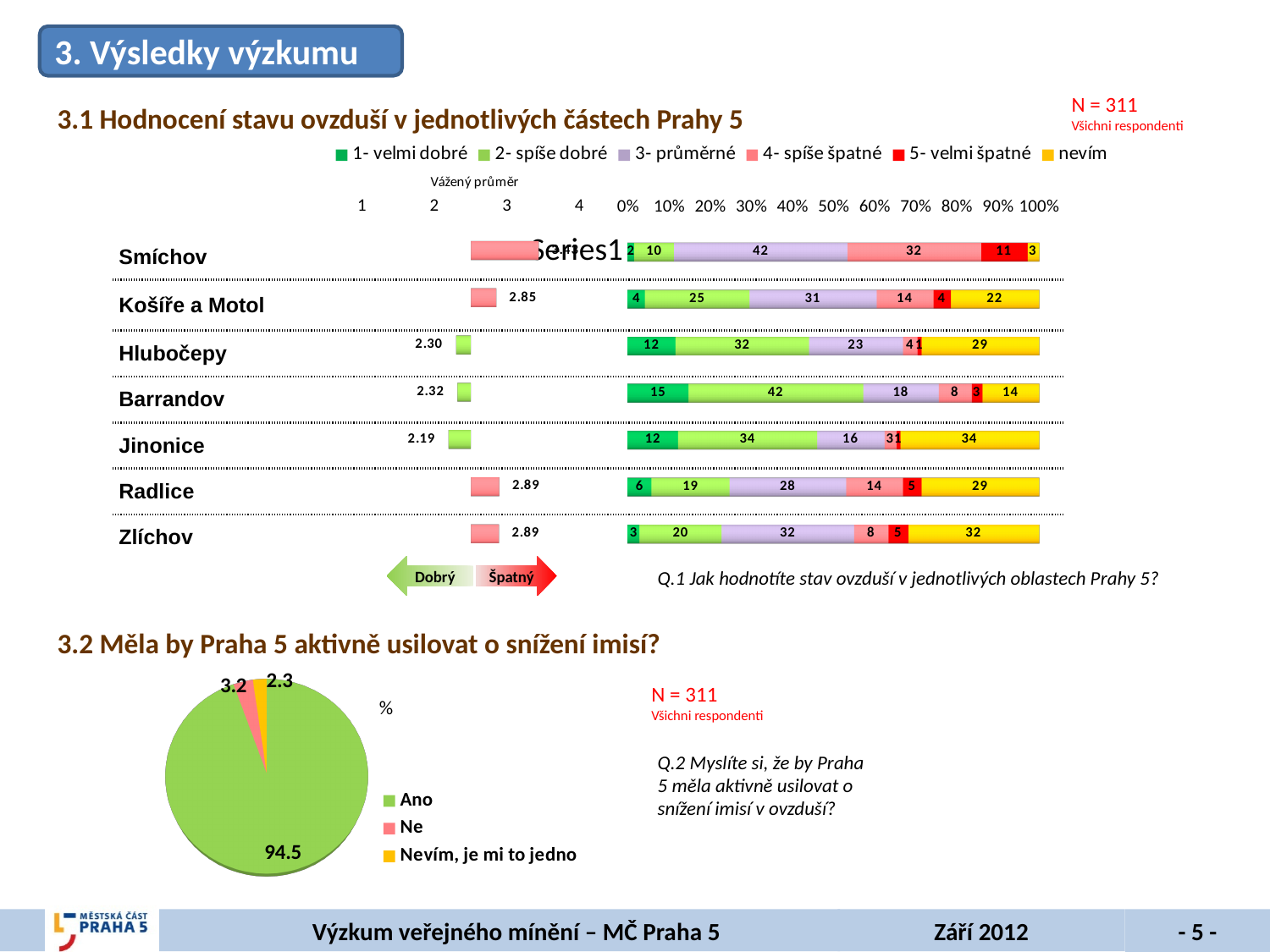
How many areas of Prague 5 are listed in the chart under 3.1 Hodnocení stavu ovzduší? 7 How many series does the legend of the stacked bar chart under 3.1 list? 6 In the pie chart under 3.2, which answer has the smallest share? Nevím, je mi to jedno What kind of chart is shown under 3.2 Měla by Praha 5 aktivně usilovat o snížení imisí? pie chart In the stacked bar chart under 3.1, what is the value for 2- spíše dobré for Barrandov? 42 In the pie chart under 3.2, how many slices does the pie have? 3 In the stacked bar chart under 3.1, which area has the highest value for 3- průměrné? Smíchov In the pie chart under 3.2 Měla by Praha 5 aktivně usilovat o snížení imisí?, what percentage of respondents answered Ano? 94.5 In the stacked bar chart under 3.1, what is the difference between the nevím values for Radlice and Košíře a Motol? 7 In the stacked bar chart under 3.1 Hodnocení stavu ovzduší, what is the value for 3- průměrné for Smíchov? 42 In the Vážený průměr chart under 3.1, which area has the lowest weighted average? Jinonice In the Vážený průměr chart under 3.1, what is the weighted average for Radlice? 2.89